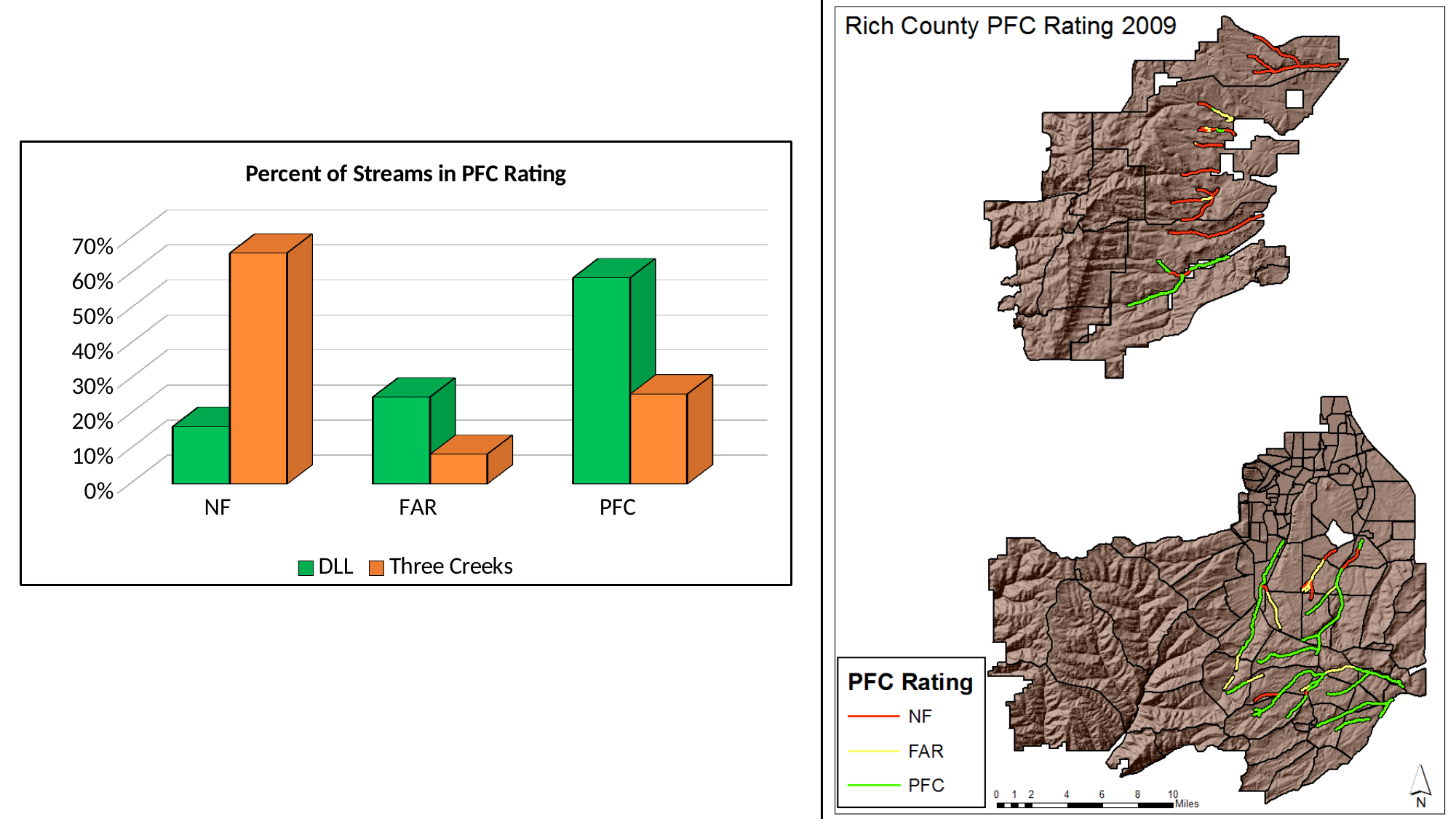
In the "Percent of Streams in PFC Rating" chart, what colour are the Three Creeks bars? orange How many series does the legend of the "Percent of Streams in PFC Rating" chart list? 2 In the "Percent of Streams in PFC Rating" chart, which category has the highest value for DLL? PFC In the "Percent of Streams in PFC Rating" chart, which category has the lowest value for Three Creeks? FAR In the "Percent of Streams in PFC Rating" chart, which series has the larger value for PFC, DLL or Three Creeks? DLL What kind of chart is "Percent of Streams in PFC Rating"? bar chart In the "Percent of Streams in PFC Rating" chart, is the Three Creeks value for NF greater or less than 50%? greater In the "Percent of Streams in PFC Rating" chart, which category has the highest value for Three Creeks? NF In the "Percent of Streams in PFC Rating" chart, which series has the larger value for NF, DLL or Three Creeks? Three Creeks How many categories are shown on the x axis of the "Percent of Streams in PFC Rating" chart? 3 In the "Percent of Streams in PFC Rating" chart, which category has the lowest value for DLL? NF In the "Percent of Streams in PFC Rating" chart, is the Three Creeks value for FAR greater or less than 20%? less